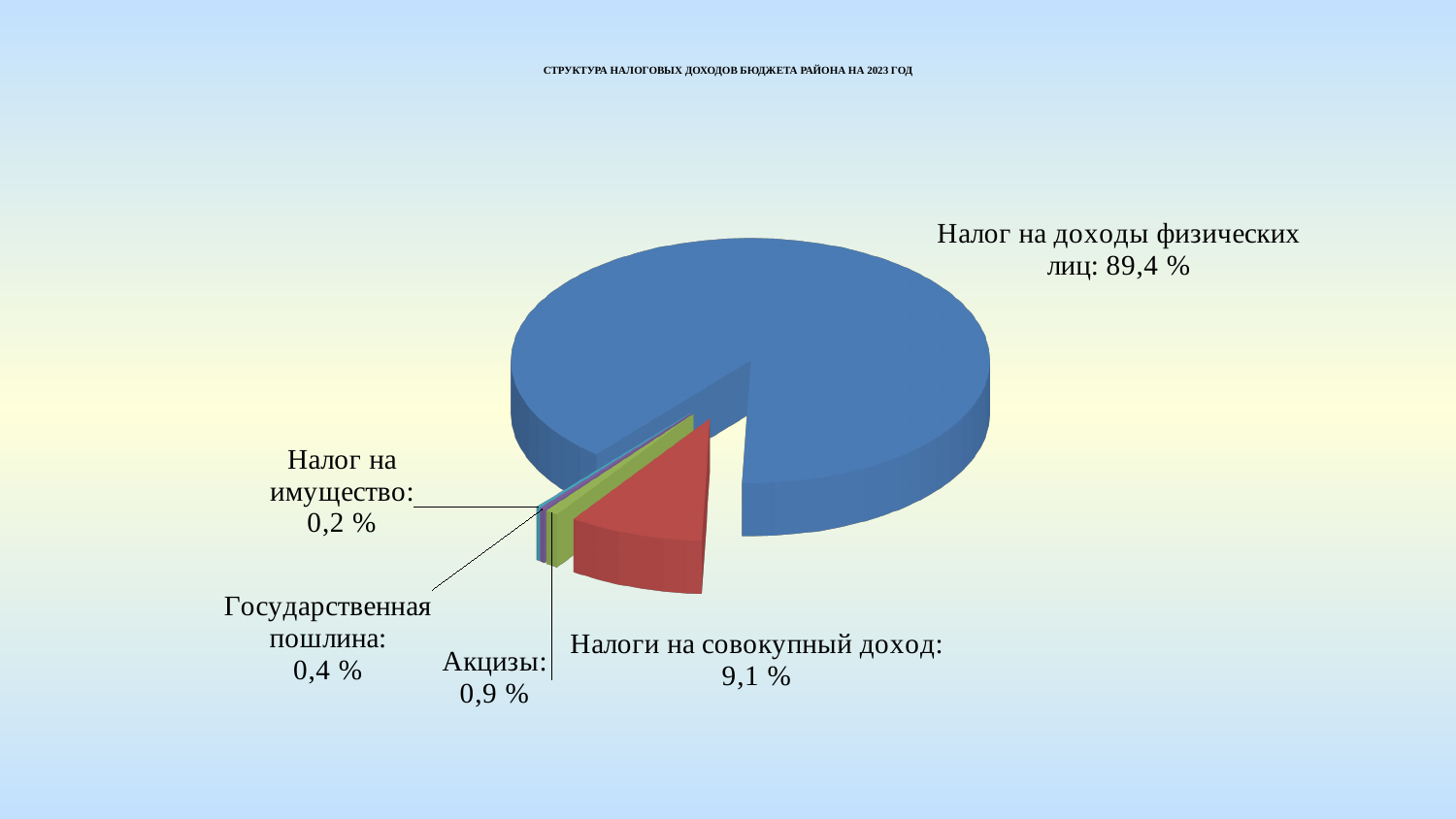
What is the share of "Налог на имущество"? 0,2 % What is the title of the chart? СТРУКТУРА НАЛОГОВЫХ ДОХОДОВ БЮДЖЕТА РАЙОНА НА 2023 ГОД What is the share of "Налоги на совокупный доход"? 9,1 % Which category has the smallest share of the pie? Налог на имущество What type of chart is shown on the slide? Pie chart What is the share of "Акцизы"? 0,9 % What is the share of "Государственная пошлина"? 0,4 % How many slices does the pie chart have? 5 Which category has the largest share of the pie? Налог на доходы физических лиц Which is larger: the share of "Акцизы" or the share of "Государственная пошлина"? Акцизы What is the difference in percentage points between "Налог на доходы физических лиц" and "Налоги на совокупный доход"? 80,3 What is the share of "Налог на доходы физических лиц" in the pie chart? 89,4 %